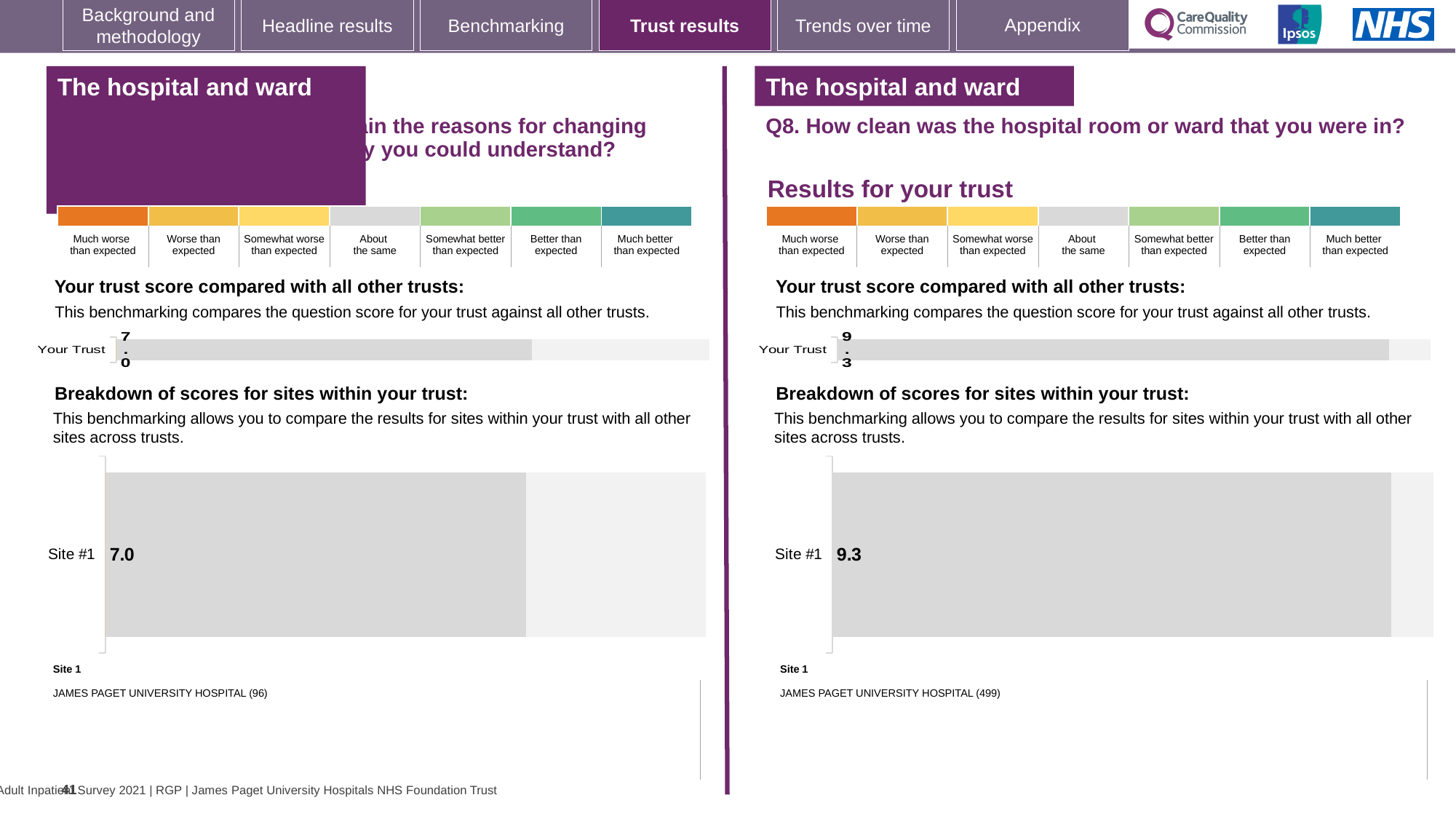
Is the Your Trust score in the left-hand 'Your trust score compared with all other trusts' chart greater or less than the Your Trust score in the right-hand chart? less Which site is listed as Site 1 beneath the breakdown chart on the right-hand side (Q8)? JAMES PAGET UNIVERSITY HOSPITAL (499) On the right-hand side of the slide (Q8, how clean was the hospital room or ward), what is the score shown for Your Trust in the 'Your trust score compared with all other trusts' chart? 9.3 On the left-hand side of the slide, what score is shown for Site #1 in the 'Breakdown of scores for sites within your trust' chart? 7.0 On the right-hand side of the slide (Q8), what score is shown for Site #1 in the 'Breakdown of scores for sites within your trust' chart? 9.3 How many sites are plotted in the 'Breakdown of scores for sites within your trust' chart on the right-hand side (Q8)? 1 What is the question text shown above the charts on the right-hand side of the slide? Q8. How clean was the hospital room or ward that you were in? On the left-hand side of the slide, what is the score shown for Your Trust in the 'Your trust score compared with all other trusts' chart? 7.0 Which is larger: the Site #1 score in the left-hand breakdown chart or the Site #1 score in the right-hand (Q8) breakdown chart? The right-hand (Q8) chart What type of chart is used to show the Site #1 score in the 'Breakdown of scores for sites within your trust' section on the right-hand side? Bar chart What is the difference between the Your Trust score on the right-hand side (Q8) and the Your Trust score on the left-hand side of the slide? 2.3 How many sites are plotted in the 'Breakdown of scores for sites within your trust' chart on the left-hand side of the slide? 1